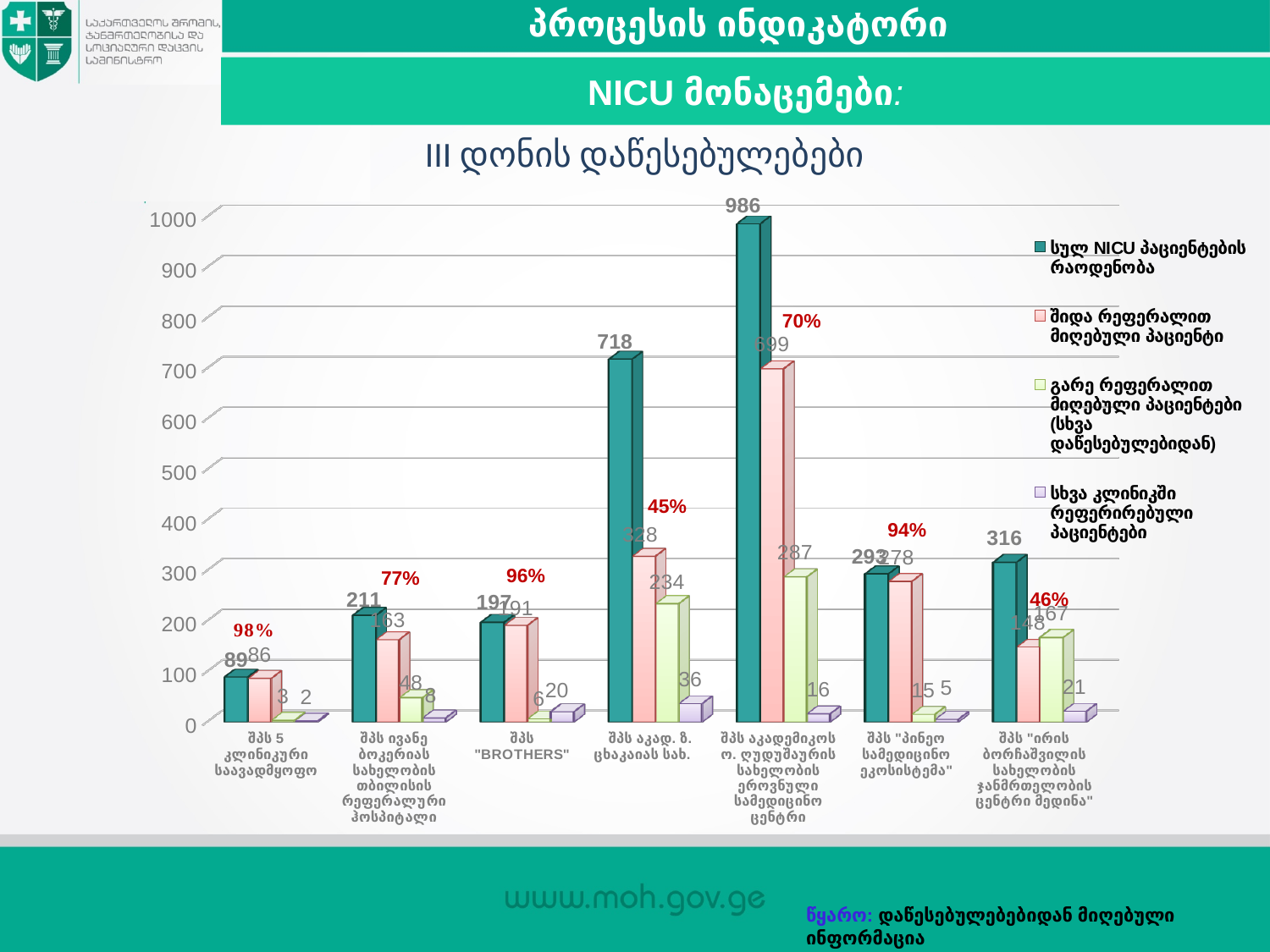
Which is larger: the გარე რეფერალით მიღებული პაციენტები value for შპს "ირის ბორჩაშვილის სახელობის ჯანმრთელობის ცენტრი მედინა" or for შპს ივანე ბოკერიას სახელობის თბილისის რეფერალური ჰოსპიტალი? შპს "ირის ბორჩაშვილის სახელობის ჯანმრთელობის ცენტრი მედინა" What is the value of სულ NICU პაციენტების რაოდენობა for შპს "BROTHERS"? 197 Which institution has the highest value for სულ NICU პაციენტების რაოდენობა? შპს აკადემიკოს ო. ღუდუშაურის სახელობის ეროვნული სამედიცინო ცენტრი What is the title of the chart? III დონის დაწესებულებები Which institution has the lowest value for სულ NICU პაციენტების რაოდენობა? შპს 5 კლინიკური საავადმყოფო How many series does the legend list? 4 What percentage is printed above the bars for შპს "პინეო სამედიცინო ეკოსისტემა"? 94% What type of chart is shown on the slide? bar chart What is the value of შიდა რეფერალით მიღებული პაციენტი for შპს აკად. ზ. ცხაკაიას სახ.? 328 What is the difference between the სულ NICU პაციენტების რაოდენობა values for შპს აკადემიკოს ო. ღუდუშაურის სახელობის ეროვნული სამედიცინო ცენტრი and შპს აკად. ზ. ცხაკაიას სახ.? 268 What is the value of სხვა კლინიკაში რეფერირებული პაციენტები for შპს აკად. ზ. ცხაკაიას სახ.? 36 How many categories (institutions) are shown on the x axis? 7